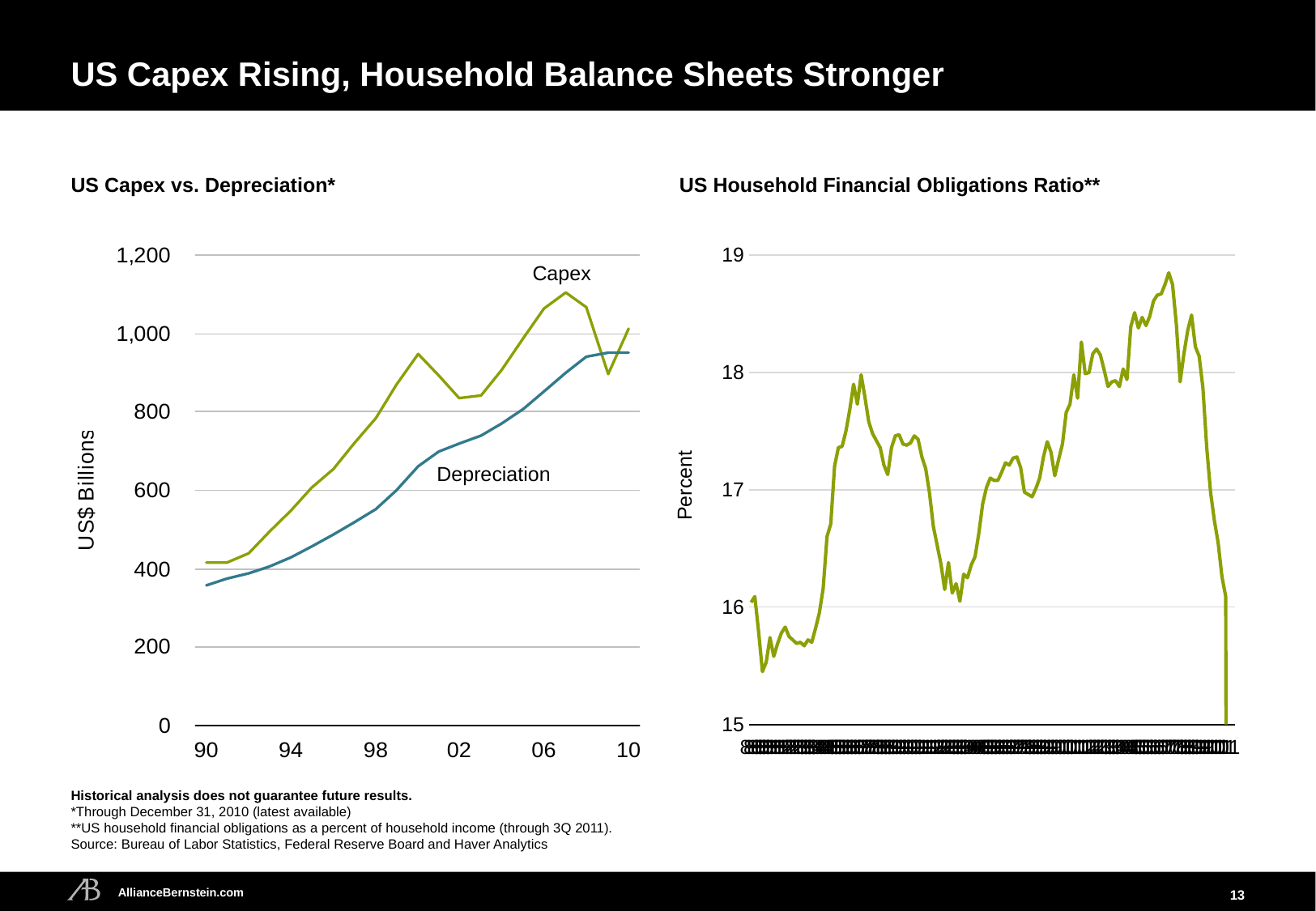
What kind of chart is the 'US Capex vs. Depreciation*' chart on the left? line chart On the 'US Capex vs. Depreciation*' chart, does the Depreciation line generally rise or fall from 1990 to 2010? rise On the 'US Capex vs. Depreciation*' chart, is the Depreciation value in 2010 greater or less than 1,000? less On the 'US Capex vs. Depreciation*' chart, is the Capex value in 2006 greater or less than 1,000? greater On the 'US Household Financial Obligations Ratio**' chart, is the lowest point of the line near the start greater or less than 16? less On the 'US Capex vs. Depreciation*' chart, which series is higher in 2006, Capex or Depreciation? Capex What kind of chart is the 'US Household Financial Obligations Ratio**' chart on the right? line chart How many series are plotted on the 'US Capex vs. Depreciation*' chart? 2 On the 'US Capex vs. Depreciation*' chart, which two series are labelled? Capex and Depreciation On the 'US Capex vs. Depreciation*' chart, what is the y-axis label? US$ Billions